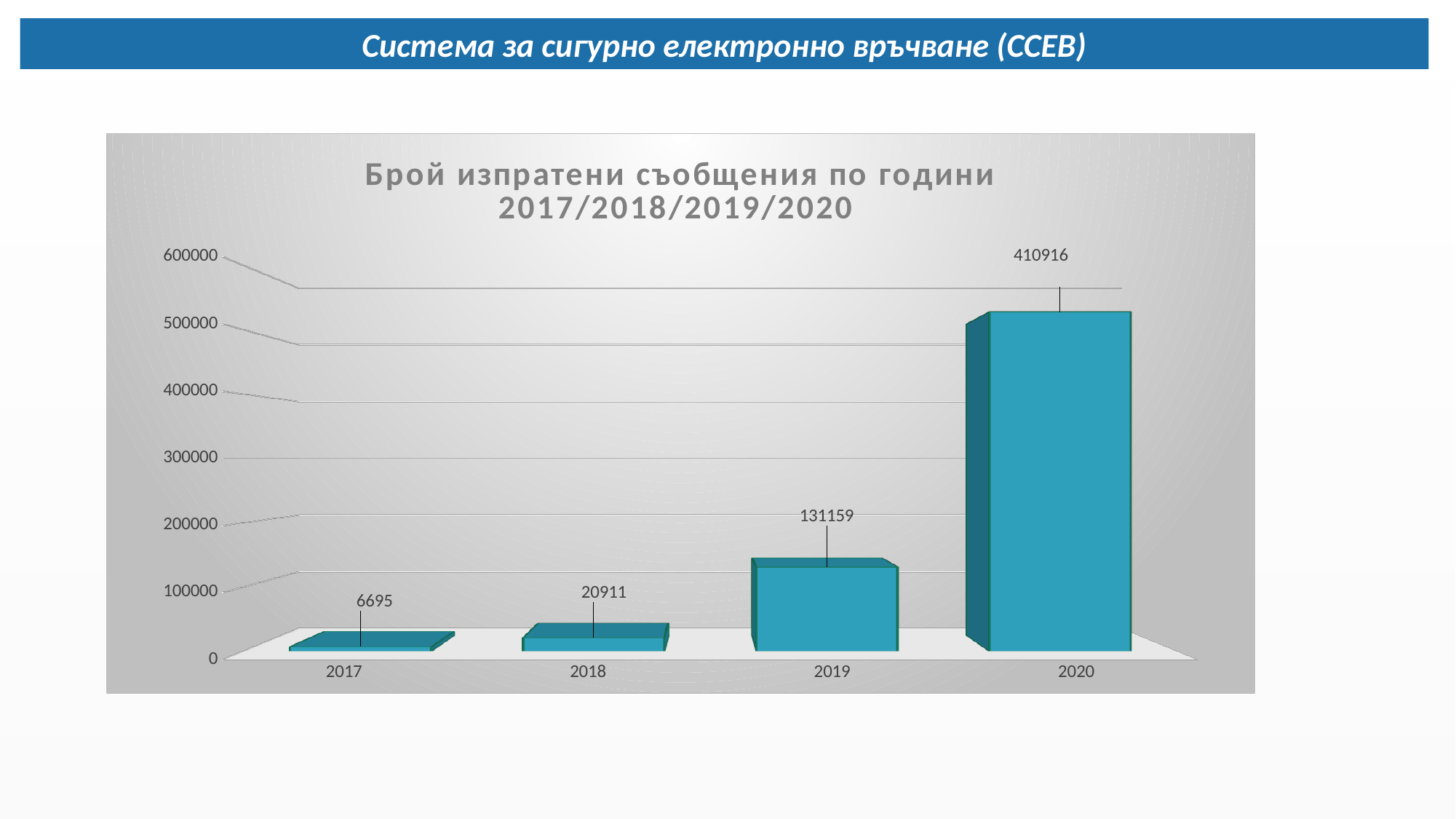
Is the value for 2020 greater or less than 400000? greater Which year has the highest value? 2020 What is the value for 2018? 20911 What is the value for 2020? 410916 Which is larger, the value for 2018 or the value for 2019? 2019 How many years are shown on the x axis? 4 What is the value for 2019? 131159 What is the value for 2017? 6695 What is the difference between the values for 2020 and 2019? 279757 What kind of chart is shown on the slide? bar chart What is the difference between the values for 2019 and 2018? 110248 Which year has the lowest value? 2017